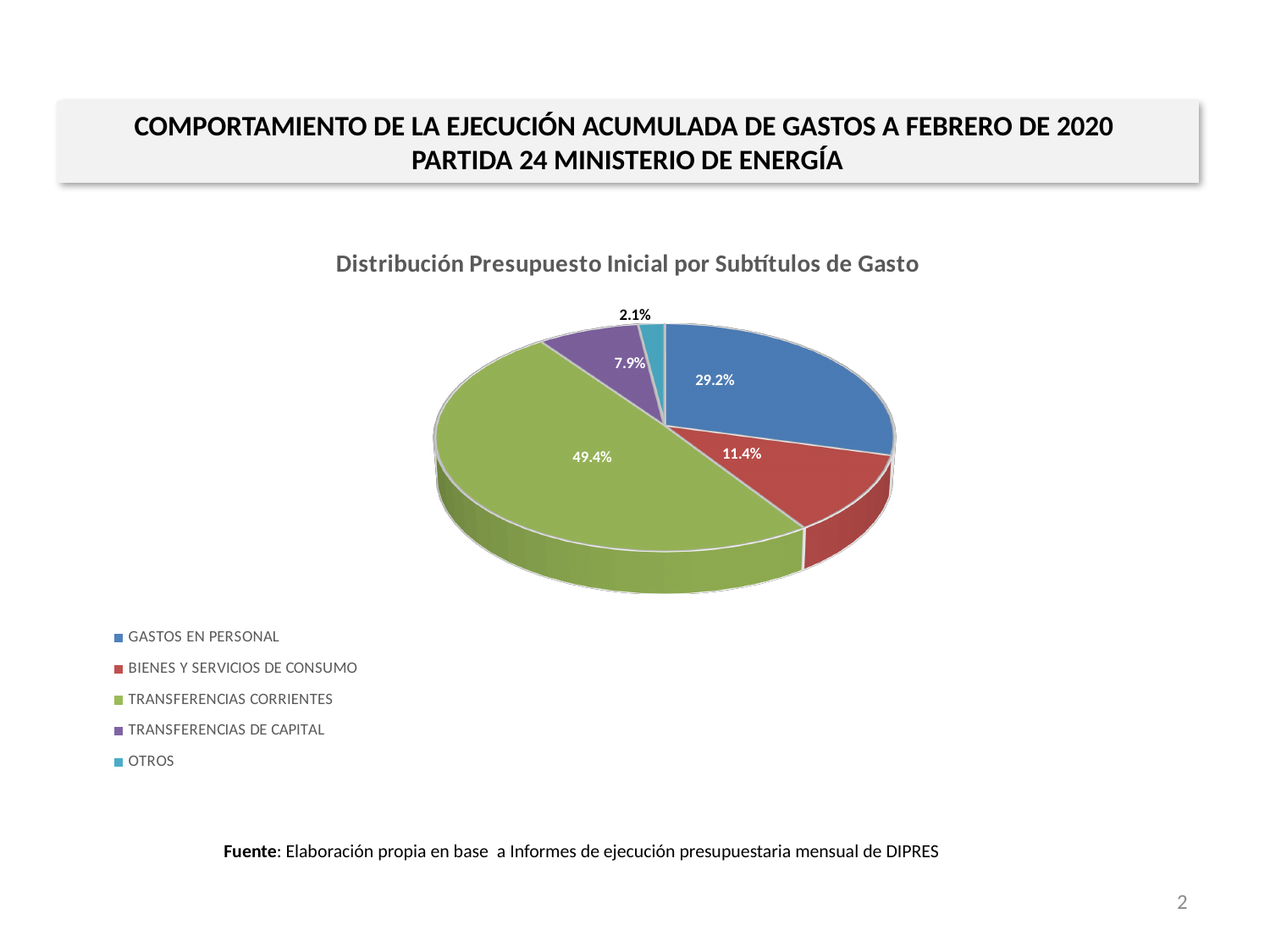
What is the value shown for OTROS? 2.1% Which category has the smallest slice of the pie? OTROS What is the value shown for GASTOS EN PERSONAL? 29.2% What is the value shown for BIENES Y SERVICIOS DE CONSUMO? 11.4% What is the title of the chart? Distribución Presupuesto Inicial por Subtítulos de Gasto Which is larger, the share for BIENES Y SERVICIOS DE CONSUMO or the share for TRANSFERENCIAS DE CAPITAL? BIENES Y SERVICIOS DE CONSUMO What is the value shown for TRANSFERENCIAS DE CAPITAL? 7.9% What is the difference between the shares of TRANSFERENCIAS CORRIENTES and GASTOS EN PERSONAL? 20.2% Which category has the largest slice of the pie? TRANSFERENCIAS CORRIENTES What type of chart is shown on the slide? Pie chart How many categories does the legend list? 5 What share of the pie does TRANSFERENCIAS CORRIENTES represent? 49.4%